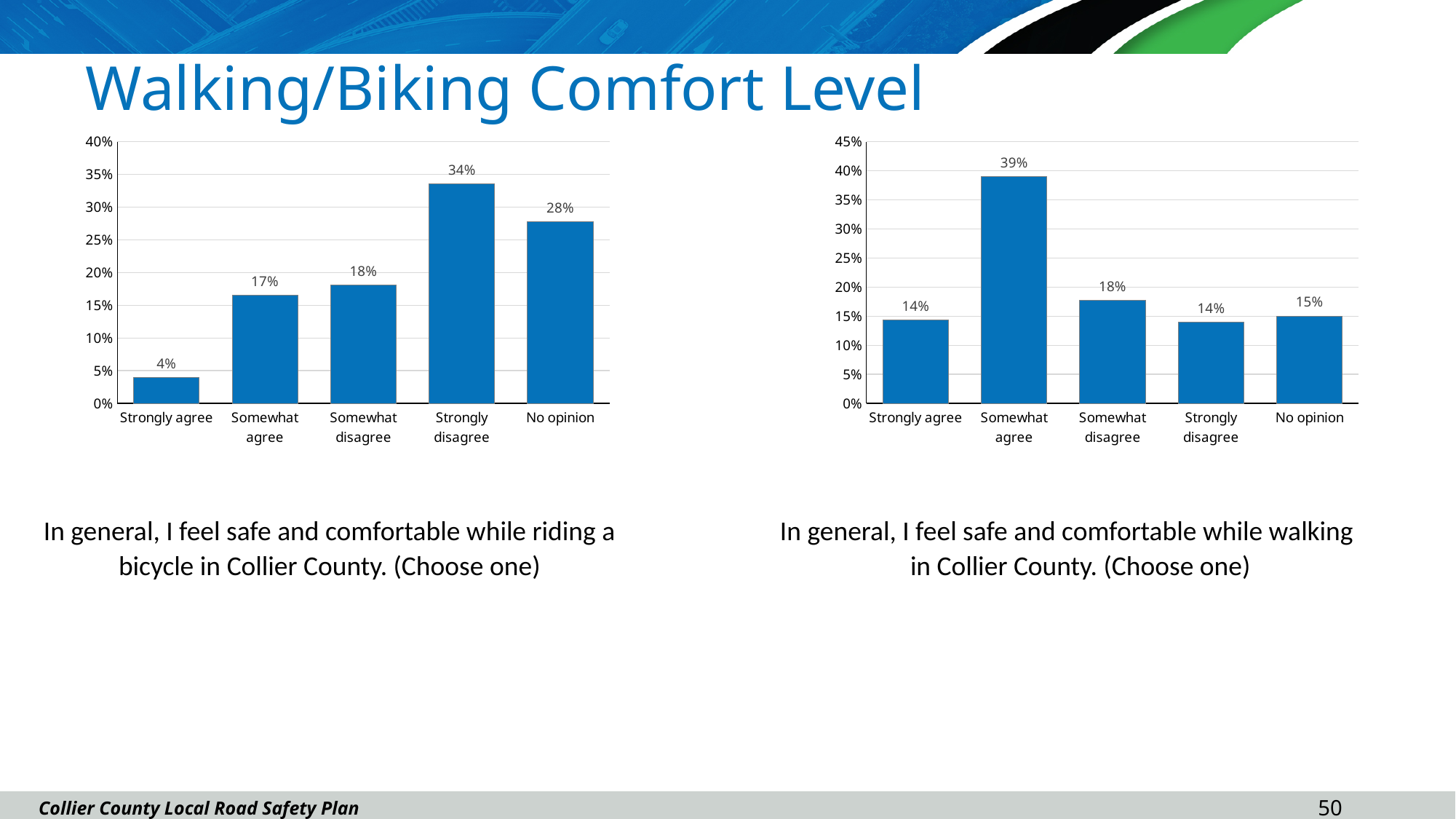
In the left chart (riding a bicycle), what is the difference between 'Strongly disagree' and 'No opinion'? 6% In the left chart (riding a bicycle), which category has the lowest value? Strongly agree In the right chart (walking), what percentage of respondents chose 'Somewhat agree'? 39% In the right chart (walking), which category has the highest value? Somewhat agree What kind of chart is the right chart (walking)? Bar chart In the left chart (riding a bicycle), what percentage of respondents chose 'Strongly disagree'? 34% In the right chart (walking), is the value for 'Somewhat agree' greater or less than 35%? greater How many categories are shown in the left chart (riding a bicycle)? 5 What is the title of the slide containing the two charts? Walking/Biking Comfort Level In the left chart (riding a bicycle), which is larger: 'Somewhat agree' or 'No opinion'? No opinion In the left chart (riding a bicycle), what is the value for 'No opinion'? 28% In the right chart (walking), what is the difference between 'Somewhat agree' and 'Somewhat disagree'? 21%